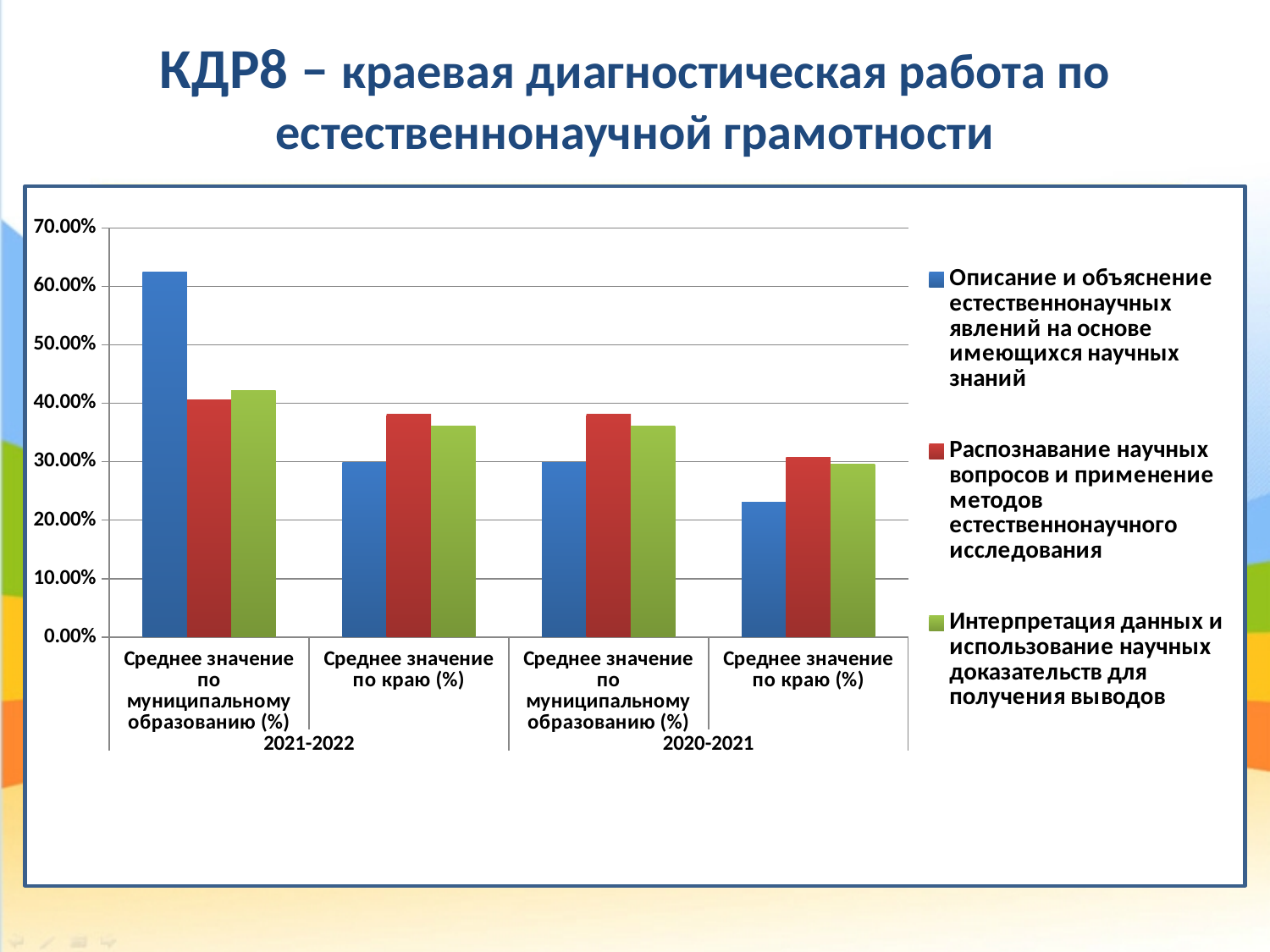
Does the series 'Описание и объяснение естественнонаучных явлений' rise or fall from the first category group to the last? fall What kind of chart is shown on the slide? bar chart In which category group is the lowest bar of the chart found? Среднее значение по краю (%) 2020-2021 In 'Среднее значение по муниципальному образованию (%)' for 2021-2022, which is larger: the value for 'Описание и объяснение естественнонаучных явлений' or for 'Распознавание научных вопросов'? Описание и объяснение естественнонаучных явлений Which colour represents the series 'Интерпретация данных и использование научных доказательств для получения выводов'? green Which series has the highest bar in the whole chart? Описание и объяснение естественнонаучных явлений на основе имеющихся научных знаний How many series does the legend list? 3 How many category groups are shown along the x axis? 4 In 'Среднее значение по краю (%)' for 2020-2021, which is larger: the value for 'Описание и объяснение естественнонаучных явлений' or for 'Интерпретация данных'? Интерпретация данных Is the value for 'Описание и объяснение естественнонаучных явлений' in 'Среднее значение по краю (%)' for 2020-2021 greater or less than 30.00%? less Is the value for 'Распознавание научных вопросов' in 'Среднее значение по краю (%)' for 2021-2022 greater or less than 30.00%? greater Is the value for 'Описание и объяснение естественнонаучных явлений' in 'Среднее значение по муниципальному образованию (%)' for 2021-2022 greater or less than 60.00%? greater